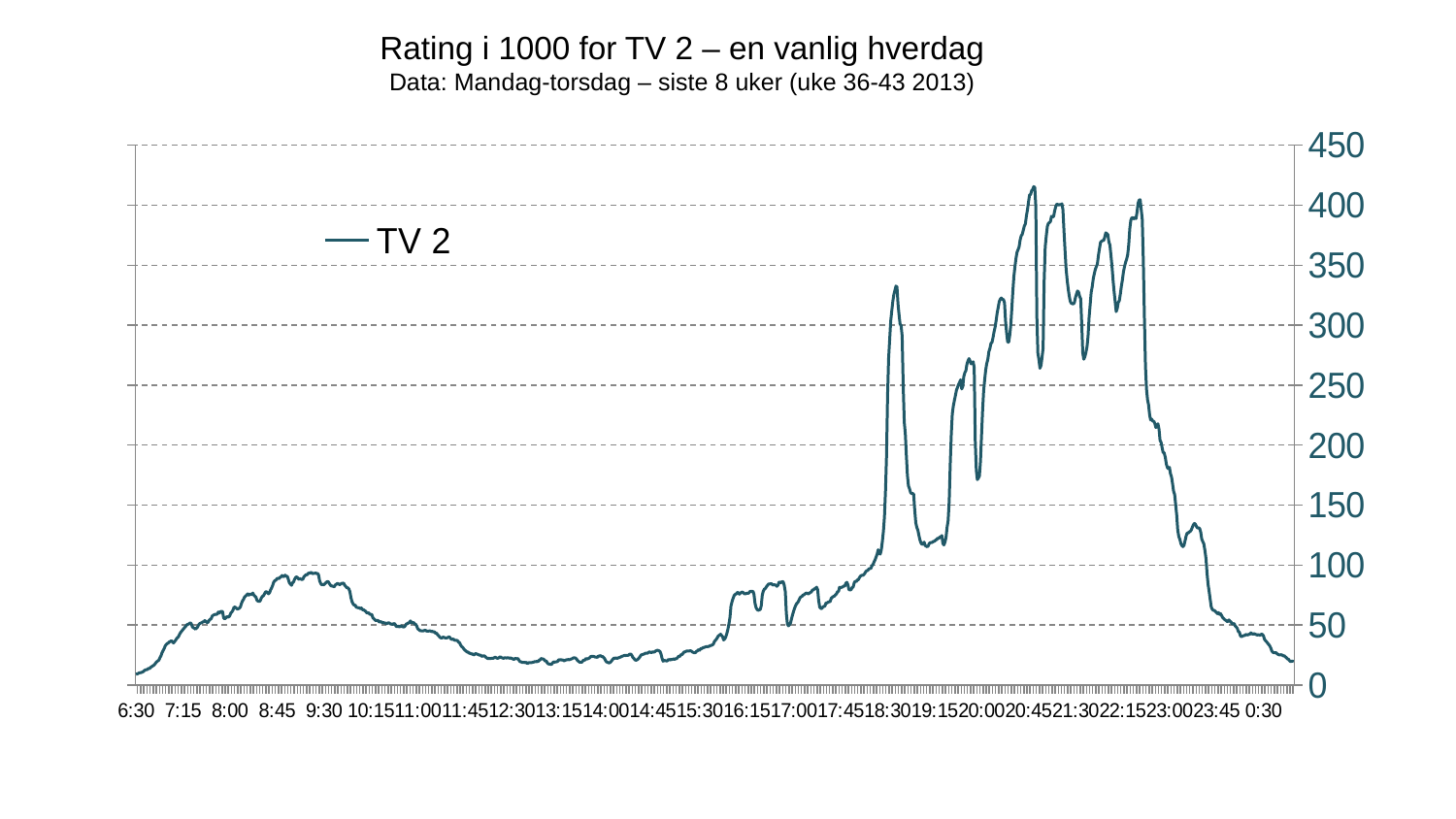
Is the value for TV 2 at 20:45 greater or less than 350? greater Does the TV 2 rating rise or fall between 23:00 and 0:30? fall What is the title of the chart? Rating i 1000 for TV 2 – en vanlig hverdag What kind of chart is shown on the slide? line chart How many series does the legend list? 1 Is the value for TV 2 at 9:30 greater or less than 100? less Is the TV 2 rating higher at 20:45 or at 12:30? 20:45 Is the value for TV 2 at 12:30 greater or less than 50? less What is the name of the series shown in the legend? TV 2 Does the TV 2 rating rise or fall between 6:30 and 9:30? rise